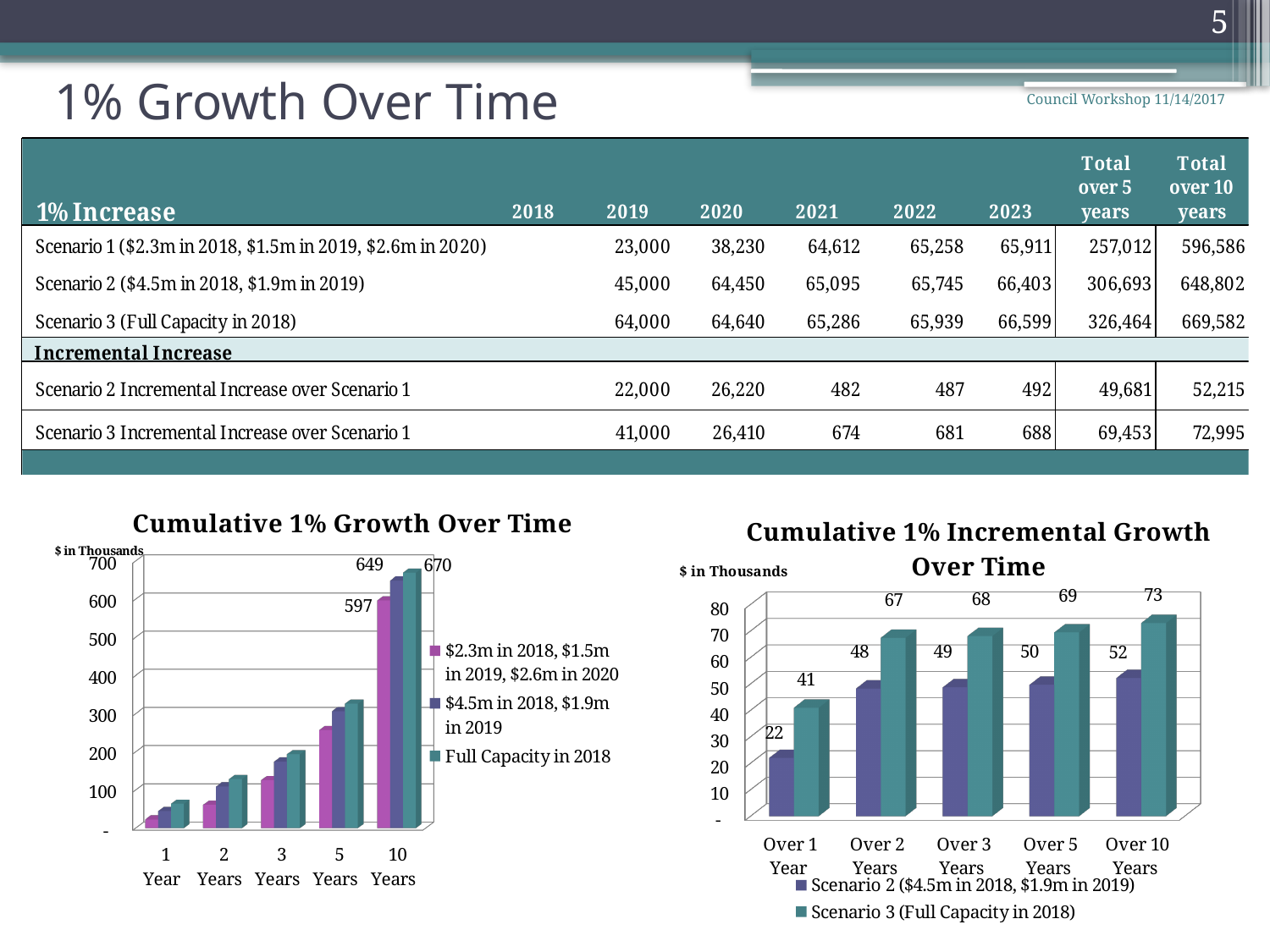
In the 'Cumulative 1% Incremental Growth Over Time' chart, what is the value for Scenario 2 over 1 year? 22 In the 'Cumulative 1% Growth Over Time' chart, what is the difference between the 'Full Capacity in 2018' and the '$2.3m in 2018, $1.5m in 2019, $2.6m in 2020' values at 10 Years? 73 In the 'Cumulative 1% Growth Over Time' chart, is the value for '$2.3m in 2018, $1.5m in 2019, $2.6m in 2020' at 5 Years greater or less than 300? less In the 'Cumulative 1% Incremental Growth Over Time' chart, do the Scenario 2 values rise or fall from 'Over 1 Year' to 'Over 10 Years'? rise How many series does the legend of the 'Cumulative 1% Growth Over Time' chart list? 3 What kind of chart is the 'Cumulative 1% Growth Over Time' chart? bar chart In the 'Cumulative 1% Incremental Growth Over Time' chart, what is the value for Scenario 3 (Full Capacity in 2018) over 10 years? 73 In the 'Cumulative 1% Growth Over Time' chart, what is the value for 'Full Capacity in 2018' at 10 Years? 670 In the 'Cumulative 1% Incremental Growth Over Time' chart, which category has the highest value for Scenario 3? Over 10 Years In the 'Cumulative 1% Incremental Growth Over Time' chart, what is the difference between Scenario 3 and Scenario 2 over 2 years? 19 How many series does the legend of the 'Cumulative 1% Incremental Growth Over Time' chart list? 2 How many categories are shown on the x axis of the 'Cumulative 1% Incremental Growth Over Time' chart? 5